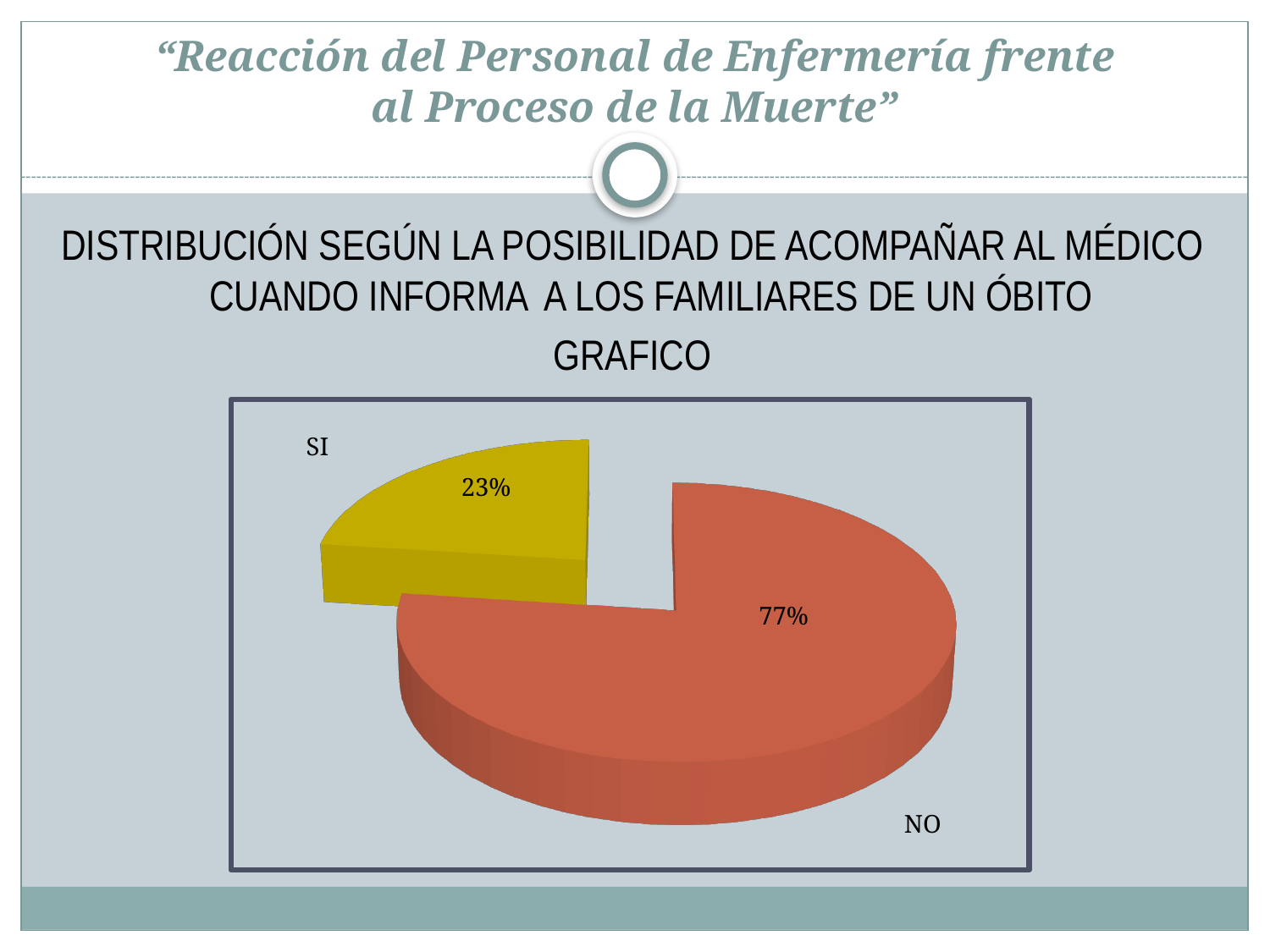
What is the difference in percentage points between the NO and SI slices? 54 What colour is the NO slice of the pie chart? Red Which slice is larger, SI or NO? NO What percentage of the pie chart corresponds to the SI category? 23% What percentage of the pie chart corresponds to the NO category? 77% What share of the pie does the SI slice represent? 23% How many categories are shown in the pie chart? 2 Which category has the smallest share of the pie chart? SI Which category has the largest share of the pie chart? NO What colour is the SI slice of the pie chart? Yellow What kind of chart is shown on the slide? Pie chart